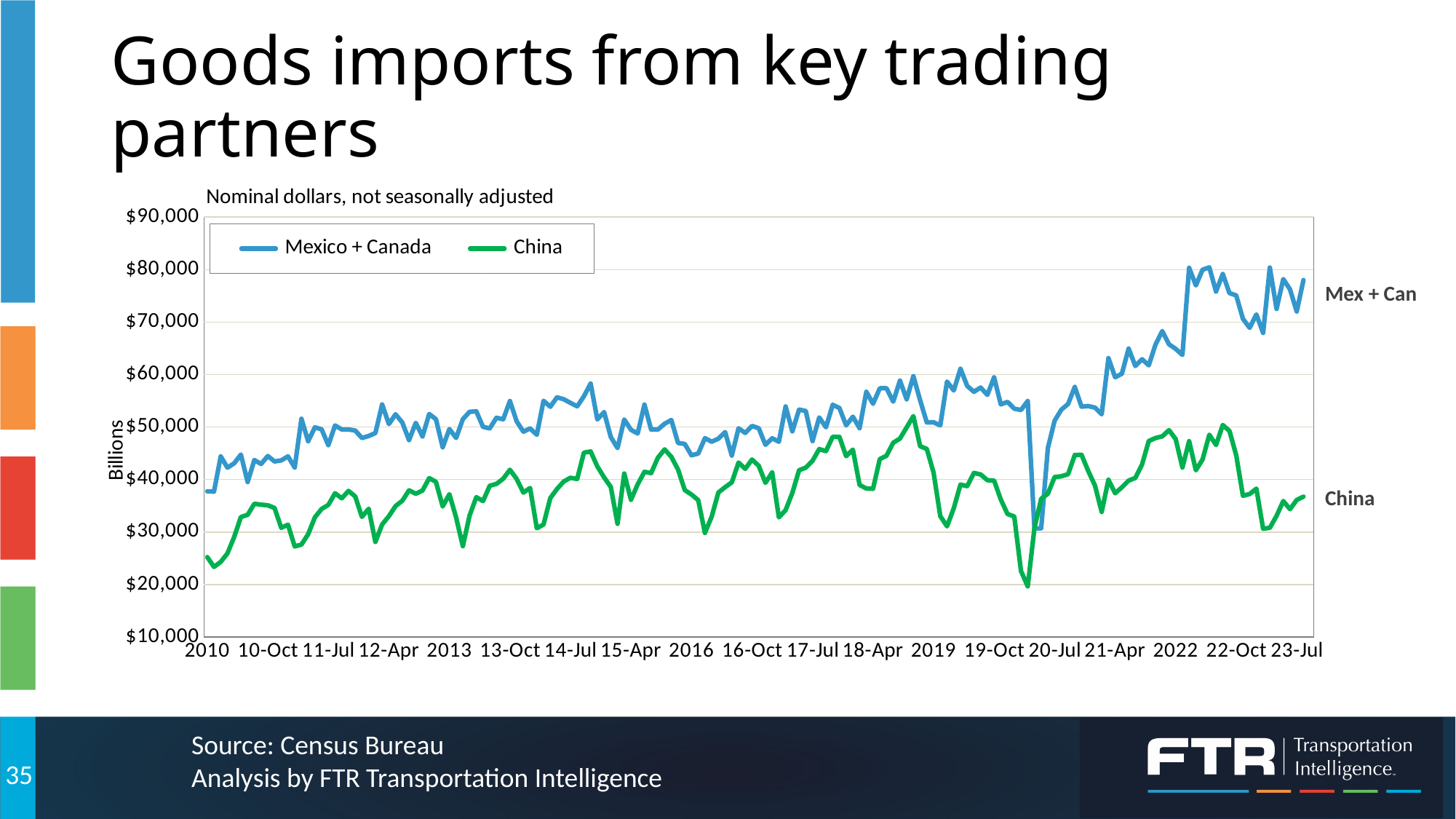
Is the value for Mexico + Canada at 2022 greater or less than $60,000? greater Is the value for China at 23-Jul greater or less than $40,000? less Does the Mexico + Canada series generally rise or fall from 2010 to 23-Jul? rise Is the lowest point of the China series greater or less than $30,000? less What are the two series named in the legend? Mexico + Canada and China What is the title of the chart on the slide? Nominal dollars, not seasonally adjusted How many series does the legend list? 2 What kind of chart is shown on the slide? line chart